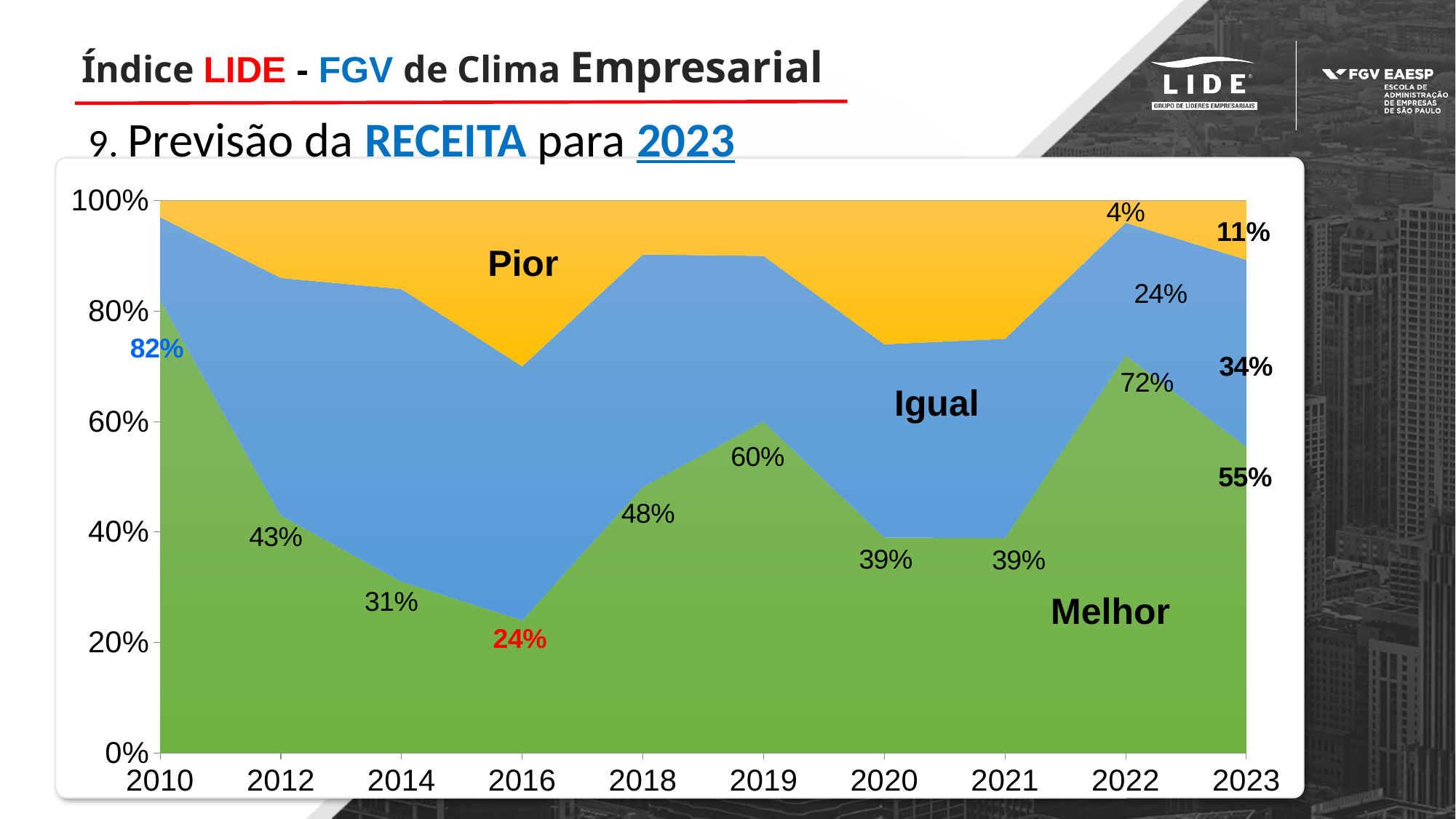
What kind of chart is shown on the slide? Stacked area chart How many years are shown along the x axis of the chart? 10 What is the value for Igual in 2023? 34% What is the value for Pior in 2022? 4% What is the value for Melhor in 2010? 82% Which series is shown in green on the chart? Melhor What is the difference between the Melhor values for 2022 and 2023? 17% In which year is the Melhor value the lowest? 2016 Is the Pior value in 2016 greater or less than 20%? greater What is the value for Melhor in 2016? 24% In which year is the Melhor value the highest? 2010 Which is larger, the Melhor value in 2019 or in 2018? 2019